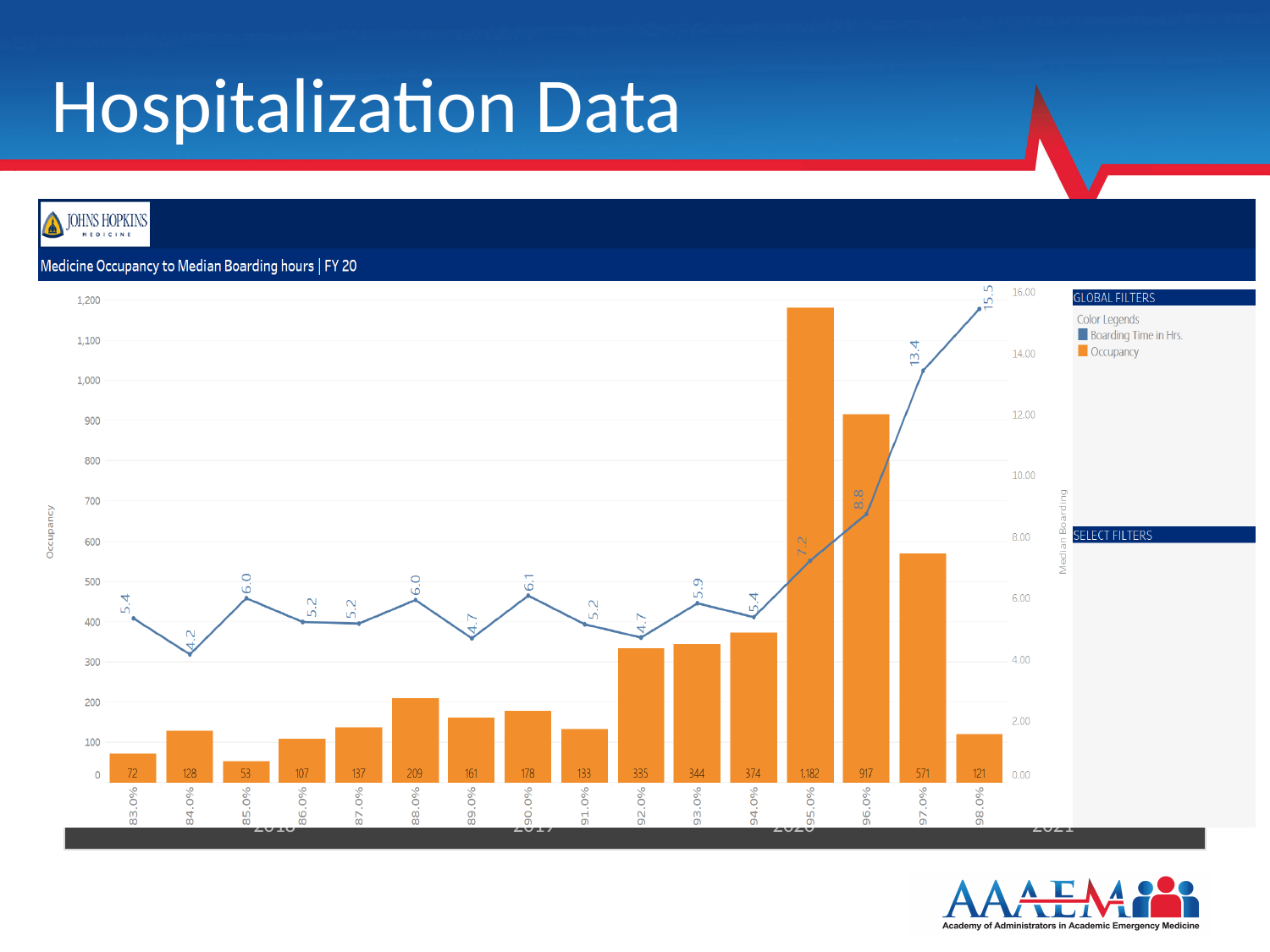
How many series does the Color Legends list? 2 What type of chart is used to show the Occupancy series? Bar chart Which occupancy percentage has the lowest Boarding Time in Hrs. value? 84.0% What is the Occupancy value at 95.0%? 1,182 Which has a larger Occupancy value, 92.0% or 93.0%? 93.0% Which occupancy percentage has the lowest Occupancy bar? 85.0% How many occupancy percentage categories are shown on the x axis? 16 What is the difference between the Boarding Time in Hrs. values at 98.0% and 97.0%? 2.1 What is the Boarding Time in Hrs. value at 84.0%? 4.2 Which occupancy percentage has the highest Occupancy bar? 95.0% What is the difference between the Occupancy values at 95.0% and 96.0%? 265 What is the Boarding Time in Hrs. value at 98.0%? 15.5